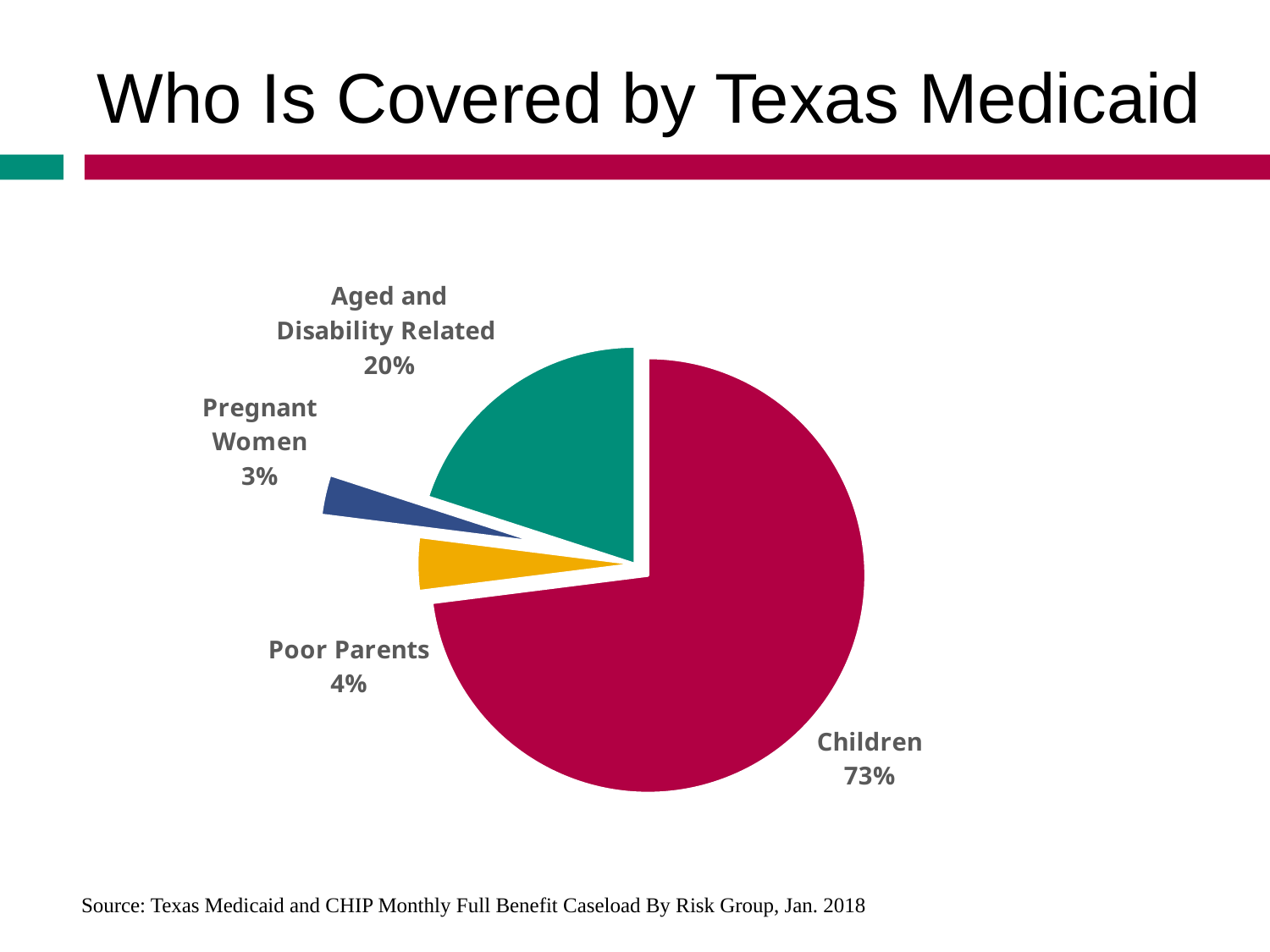
What percentage is shown for Poor Parents? 4% What colour is the Children slice of the pie? red What share of Texas Medicaid coverage is Children? 73% How many slices does the pie chart have? 4 What is the difference in percentage points between Children and Aged and Disability Related? 53 Which is larger, the share for Poor Parents or the share for Pregnant Women? Poor Parents What kind of chart is shown on the slide? pie chart What percentage is shown for Pregnant Women? 3% What share of the pie is Aged and Disability Related? 20% Which group has the smallest share of the pie? Pregnant Women What is the title of the slide containing the pie chart? Who Is Covered by Texas Medicaid Which group has the largest share of the pie? Children